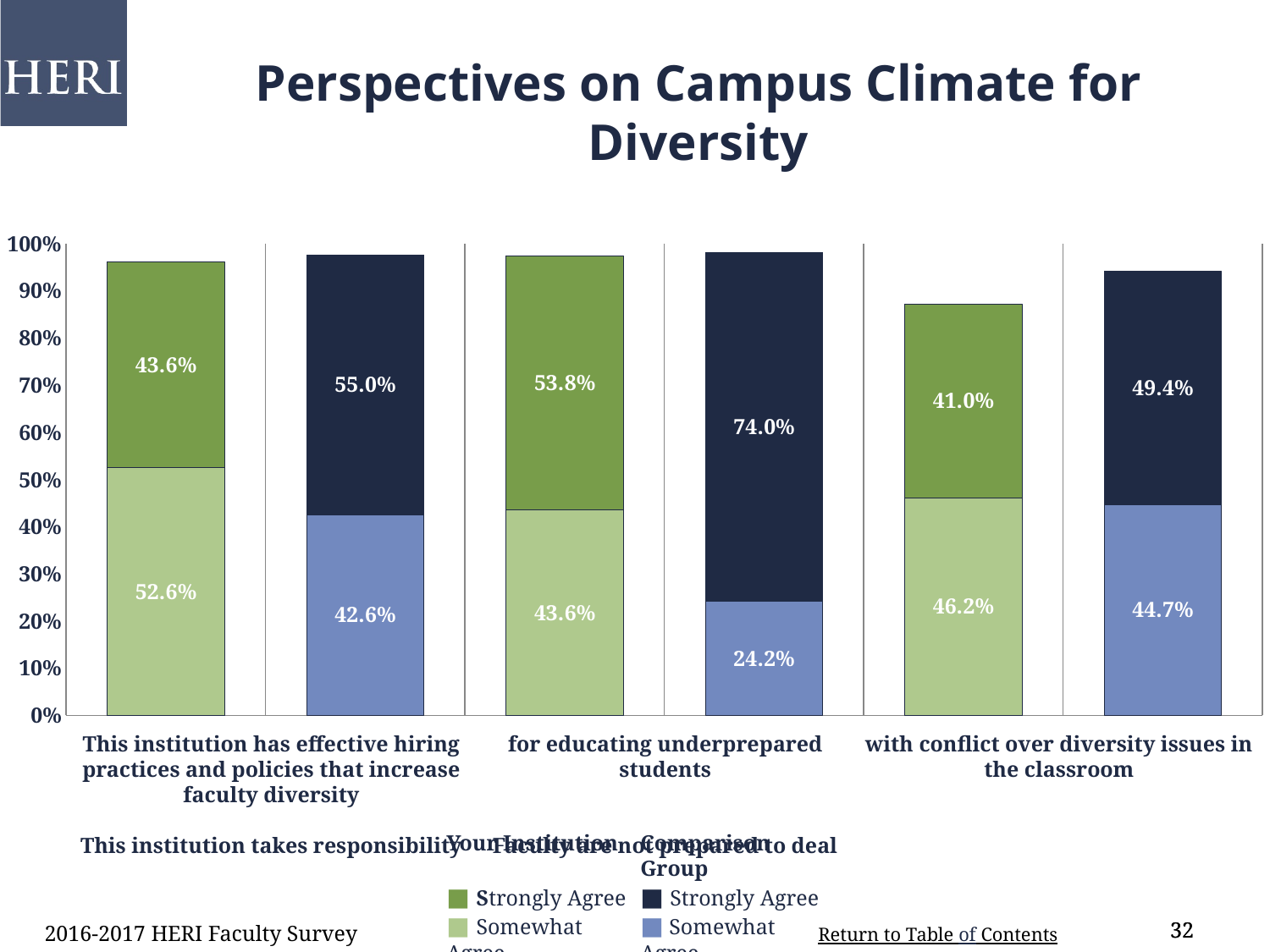
What is the total of the Comparison Group bar for 'educating underprepared students'? 98.2% Which 'Strongly Agree' value is larger for conflict over diversity issues in the classroom: Your Institution or the Comparison Group? Comparison Group What is the difference between the Comparison Group and Your Institution 'Strongly Agree' values for educating underprepared students? 20.2% What type of chart is shown on the slide? stacked bar chart What percentage of the Comparison Group somewhat agree that this institution has effective hiring practices and policies that increase faculty diversity? 42.6% What is the total of the Your Institution bar for 'This institution has effective hiring practices and policies that increase faculty diversity'? 96.2% What percentage of the Comparison Group strongly agree that this institution takes responsibility for educating underprepared students? 74.0% Which bar segment has the lowest labelled value on the chart? 24.2% What percentage of Your Institution faculty strongly agree that this institution has effective hiring practices and policies that increase faculty diversity? 43.6% What percentage of Your Institution faculty somewhat agree that faculty are not prepared to deal with conflict over diversity issues in the classroom? 46.2% How many survey statements (categories) are shown on the x axis? 3 How many entries does the legend list? 4